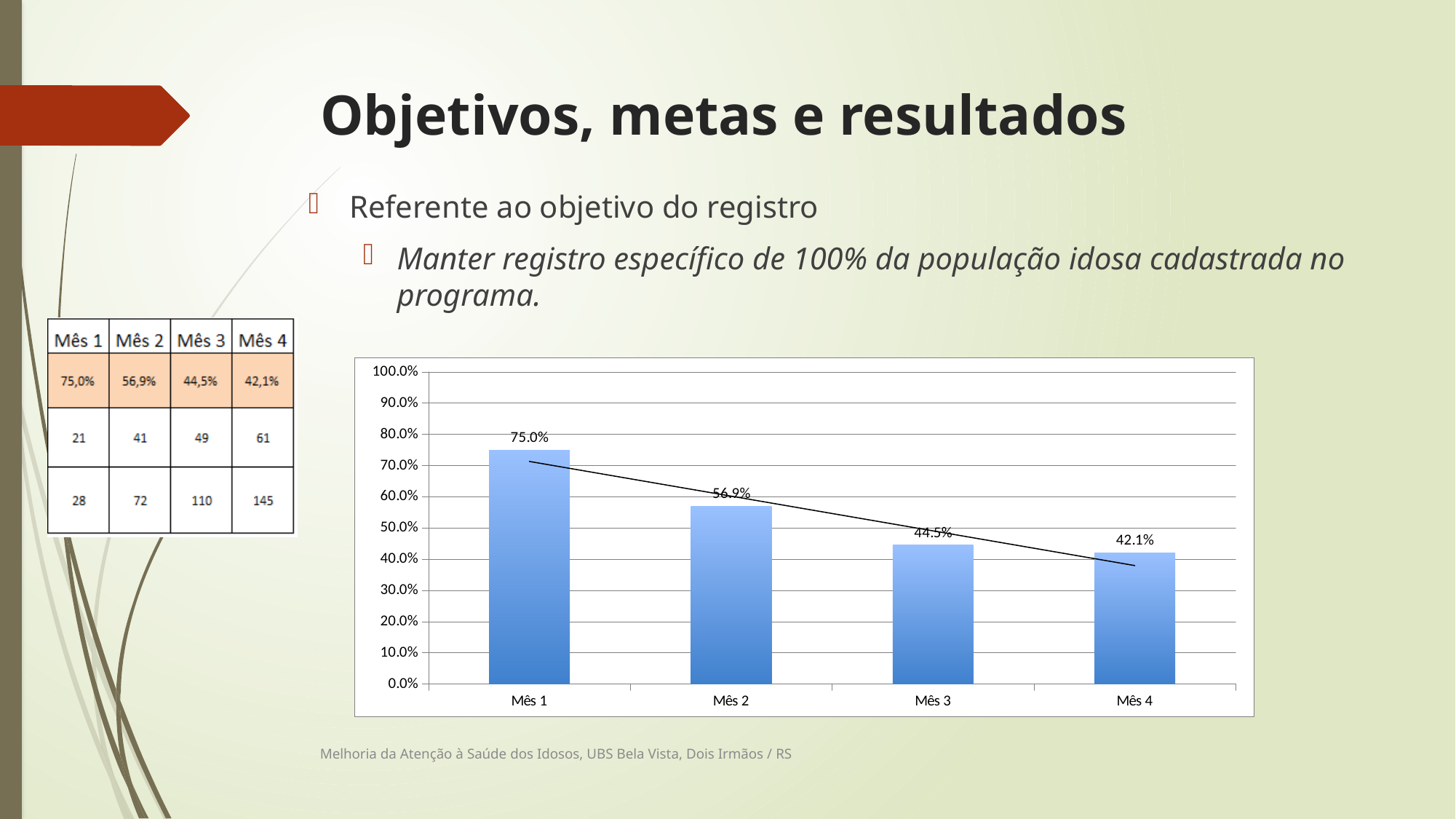
How many months are shown on the x axis of the chart? 4 Which is larger, the value for Mês 2 or the value for Mês 3? Mês 2 What is the value for Mês 2? 56.9% What is the difference between the values for Mês 1 and Mês 4? 32.9% What is the value for Mês 1? 75.0% Which month has the lowest value? Mês 4 Is the value for Mês 1 greater or less than 70.0%? greater What is the value for Mês 4? 42.1% What is the value for Mês 3? 44.5% What kind of chart is shown on the slide? bar chart Which month has the highest value? Mês 1 What is the difference between the values for Mês 2 and Mês 3? 12.4%